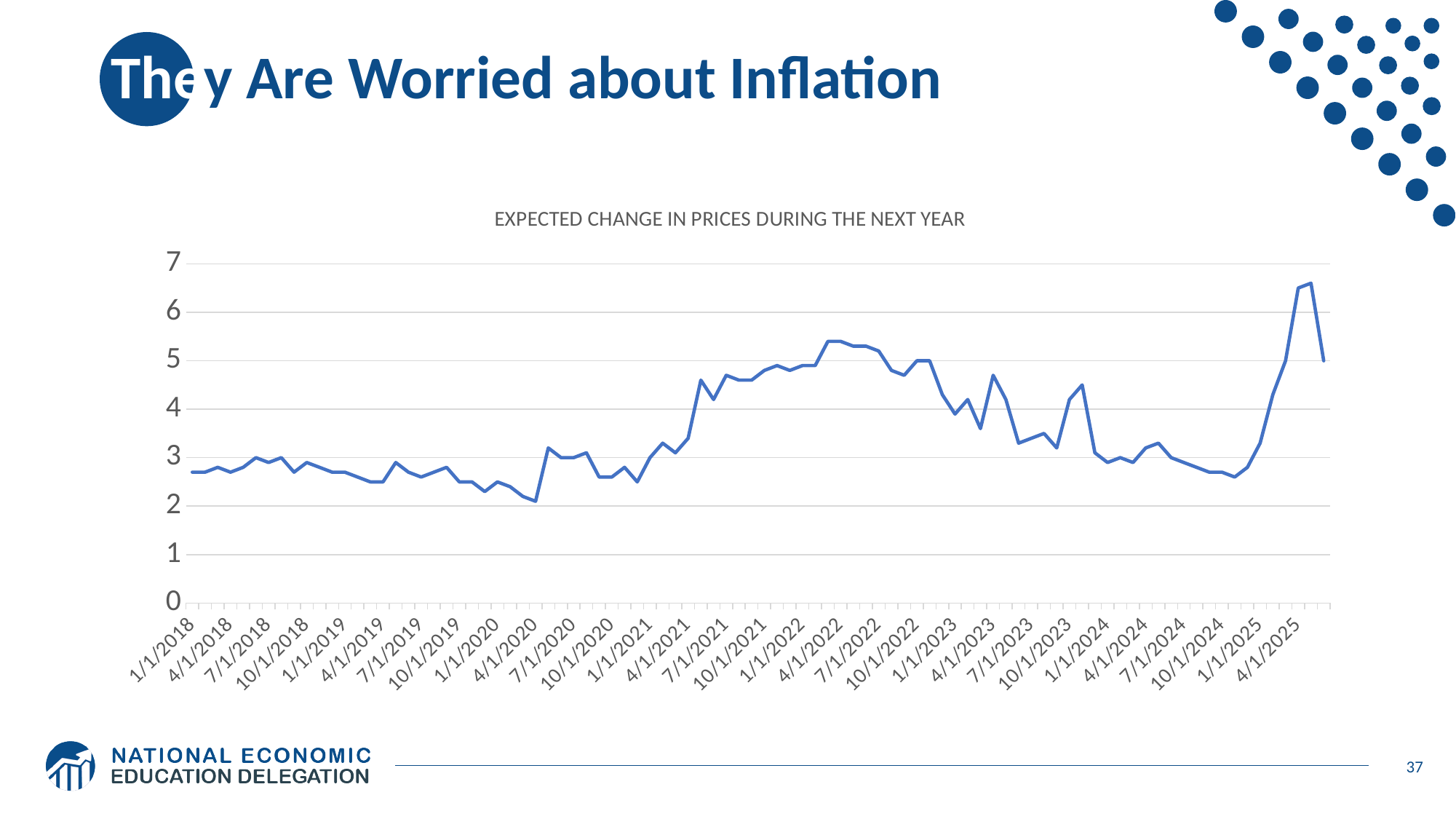
Is the value for 4/1/2022 greater or less than 5? greater Which is larger, the value for 4/1/2022 or the value for 1/1/2018? 4/1/2022 Is the value for 1/1/2018 greater or less than 3? less Is the value for 4/1/2020 greater or less than 3? less Does the line rise or fall between 1/1/2025 and its peak in 2025? rise What is the title of the chart? EXPECTED CHANGE IN PRICES DURING THE NEXT YEAR What kind of chart is shown on the slide? line chart In which year does the line reach its lowest point? 2020 In which year does the line reach its highest point? 2025